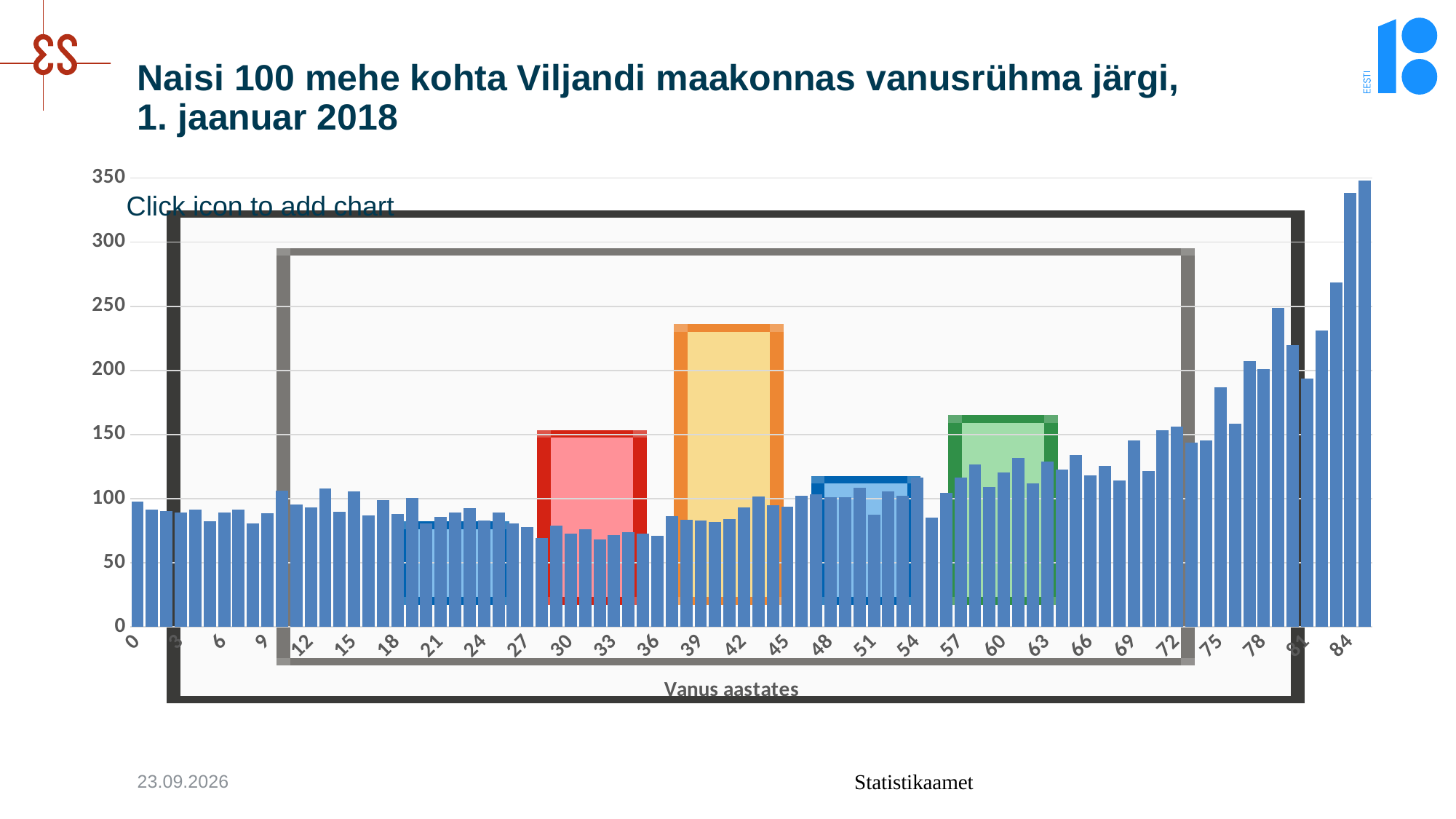
What kind of chart is shown on the slide? bar chart Is the value for age 39 greater or less than 100? less Is the value for age 84 greater or less than 300? greater Is the value for age 30 greater or less than 100? less Which is larger, the value for age 42 or the value for age 72? age 72 What is the title of the chart? Naisi 100 mehe kohta Viljandi maakonnas vanusrühma järgi, 1. jaanuar 2018 What is the label of the x axis? Vanus aastates Do the values generally rise or fall from age 60 to age 84? rise Which is larger, the value for age 84 or the value for age 0? age 84